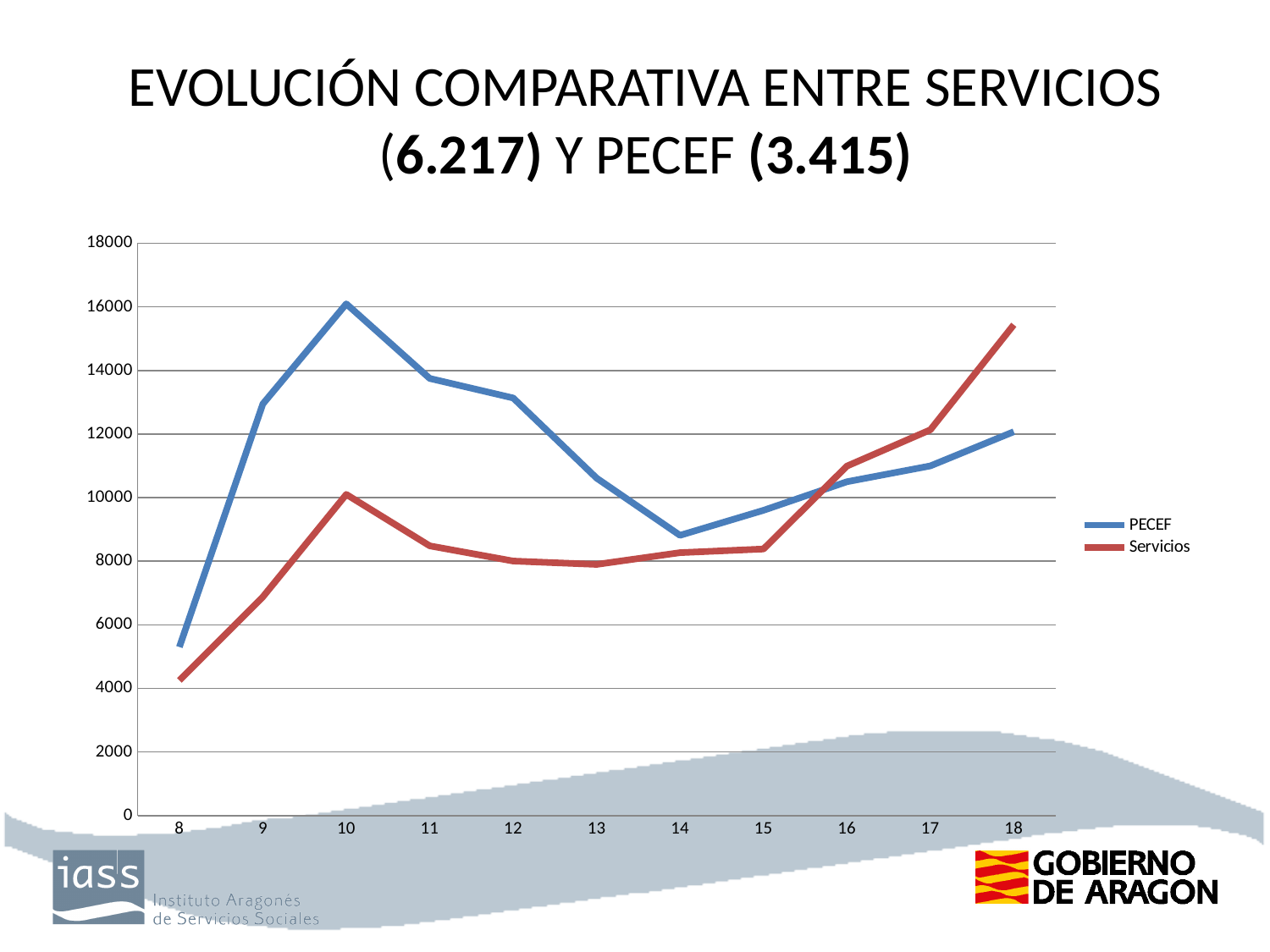
At x = 10, which series has the larger value, PECEF or Servicios? PECEF Is the value for PECEF at x = 10 greater or less than 14000? greater Is the value for Servicios at x = 8 greater or less than 6000? less Does the Servicios series rise or fall from x = 15 to x = 18? rise What kind of chart is shown on the slide? line chart At which x-axis value does the Servicios series reach its highest point? 18 How many series does the legend list? 2 How many points are plotted along the x axis for each series? 11 At which x-axis value is the PECEF series lowest? 8 At which x-axis value is the Servicios series lowest? 8 At x = 18, which series has the larger value, PECEF or Servicios? Servicios At which x-axis value does the PECEF series reach its highest point? 10